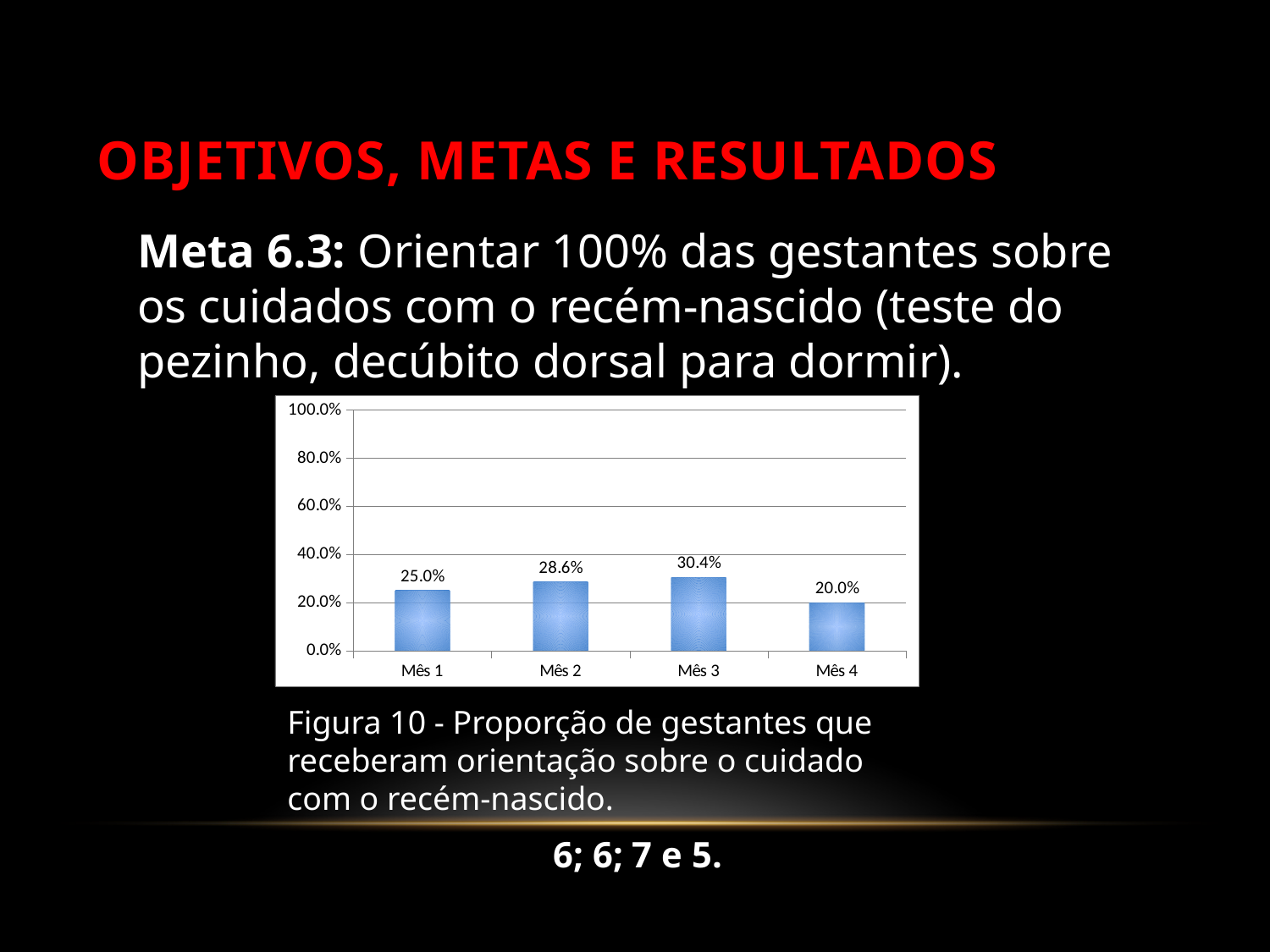
Which is larger, the value for Mês 2 or the value for Mês 4? Mês 2 Is the value for Mês 3 greater or less than 40.0%? less What is the value for Mês 4? 20.0% Which month has the highest value? Mês 3 What is the figure number given in the caption below the chart? Figura 10 Which month has the lowest value? Mês 4 What is the value for Mês 1? 25.0% How many months are shown on the x axis? 4 What is the difference between the values for Mês 3 and Mês 4? 10.4% What is the value for Mês 3? 30.4% What is the difference between the values for Mês 2 and Mês 1? 3.6% What kind of chart is shown on the slide? bar chart